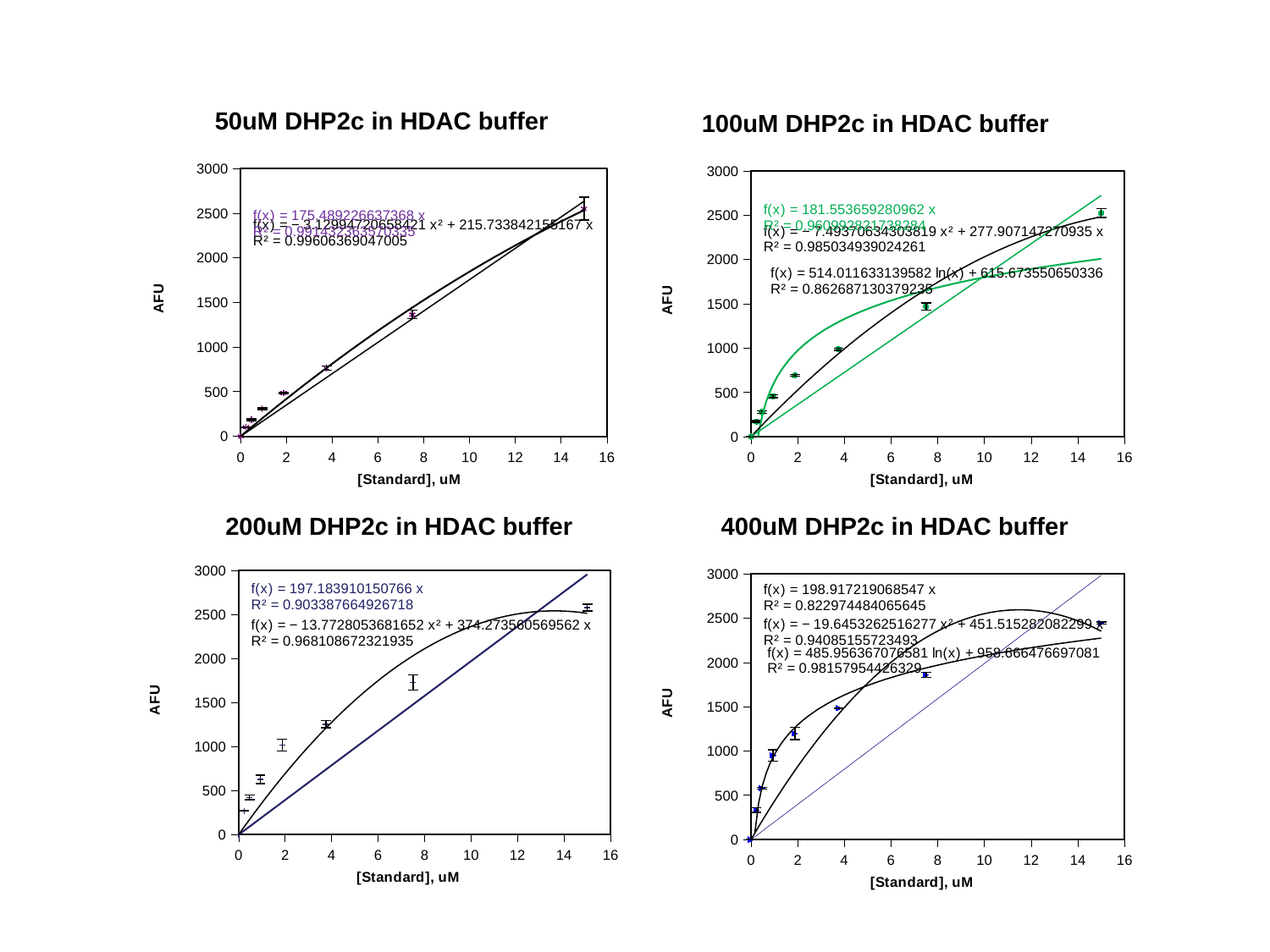
In the '100uM DHP2c in HDAC buffer' chart, is the AFU value for the point near 7.5 uM greater or less than 1000? greater In the '400uM DHP2c in HDAC buffer' chart, is the AFU value for the point near 7.5 uM greater or less than 1500? greater In the '400uM DHP2c in HDAC buffer' chart, is the AFU value for the point near 15 uM greater or less than 2000? greater In the '200uM DHP2c in HDAC buffer' chart, which data point has the highest AFU value? the point near 15 uM In the '50uM DHP2c in HDAC buffer' chart, do the AFU values rise or fall as the standard concentration increases? rise What is the x-axis label on the '200uM DHP2c in HDAC buffer' chart? [Standard], uM In the '400uM DHP2c in HDAC buffer' chart, which has the higher AFU value: the point near 1 uM or the point near 4 uM? the point near 4 uM How many charts are shown on the slide? 4 What kind of chart is '50uM DHP2c in HDAC buffer'? scatter chart In the '100uM DHP2c in HDAC buffer' chart, which data point has the lowest AFU value? the point at 0 uM